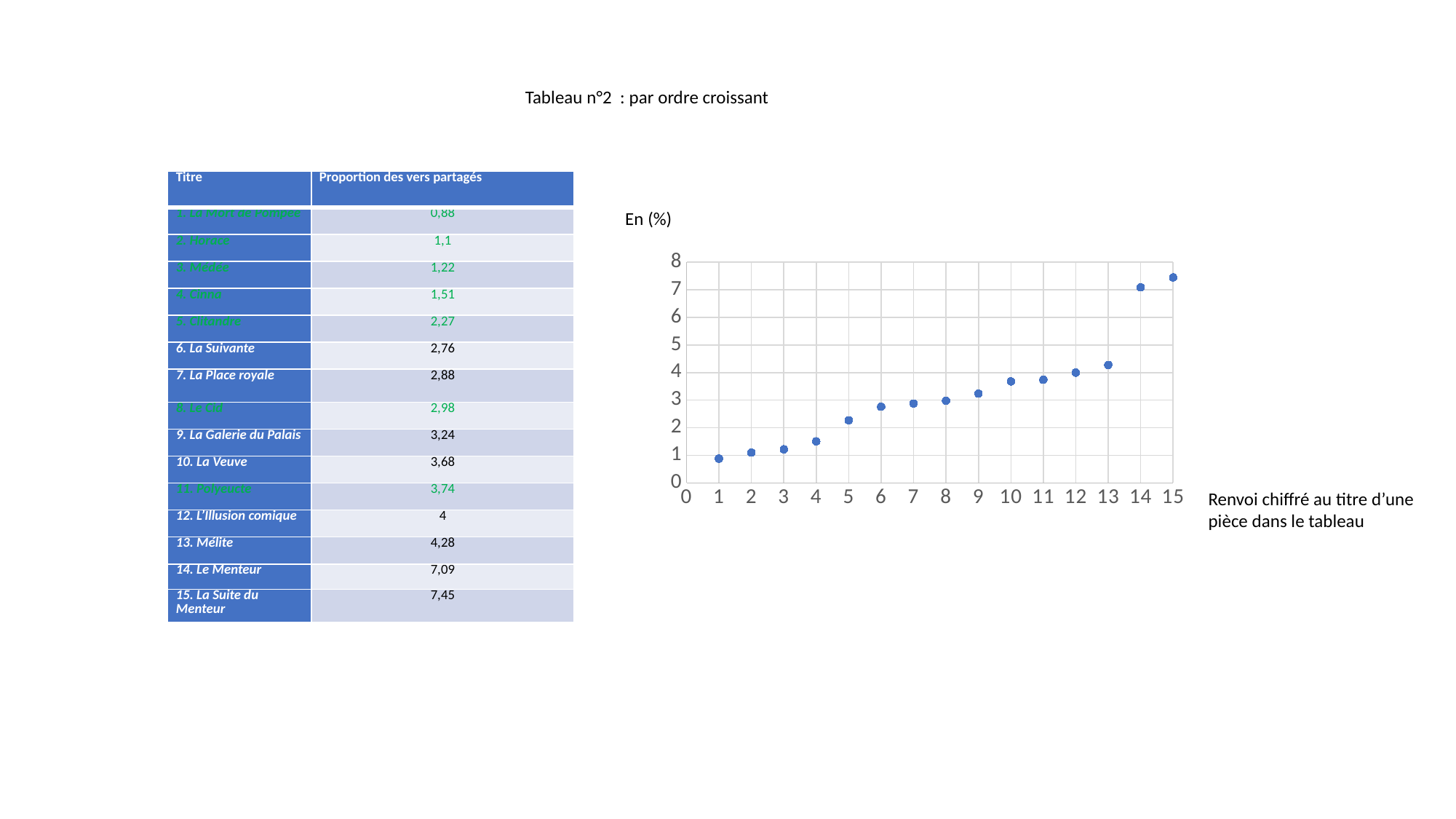
Which x-axis position has the lowest plotted value? 1 Is the plotted value at x = 9 greater or less than 3? greater Is the plotted value at x = 13 greater or less than 4? greater Which x-axis position has the highest plotted value? 15 What unit label is written above the chart? En (%) Which plotted value is larger: the one at x = 14 or the one at x = 13? x = 14 What kind of chart is shown on the slide? scatter chart According to the table, what is the difference between the values for play 15 (La Suite du Menteur) and play 14 (Le Menteur)? 0,36 Do the plotted values rise or fall as the x-axis value increases from 1 to 15? rise How many data points are plotted in the chart? 15 According to the table, what is the proportion of shared verses for play number 15, La Suite du Menteur? 7,45 Is the plotted value at x = 5 greater or less than 3? less